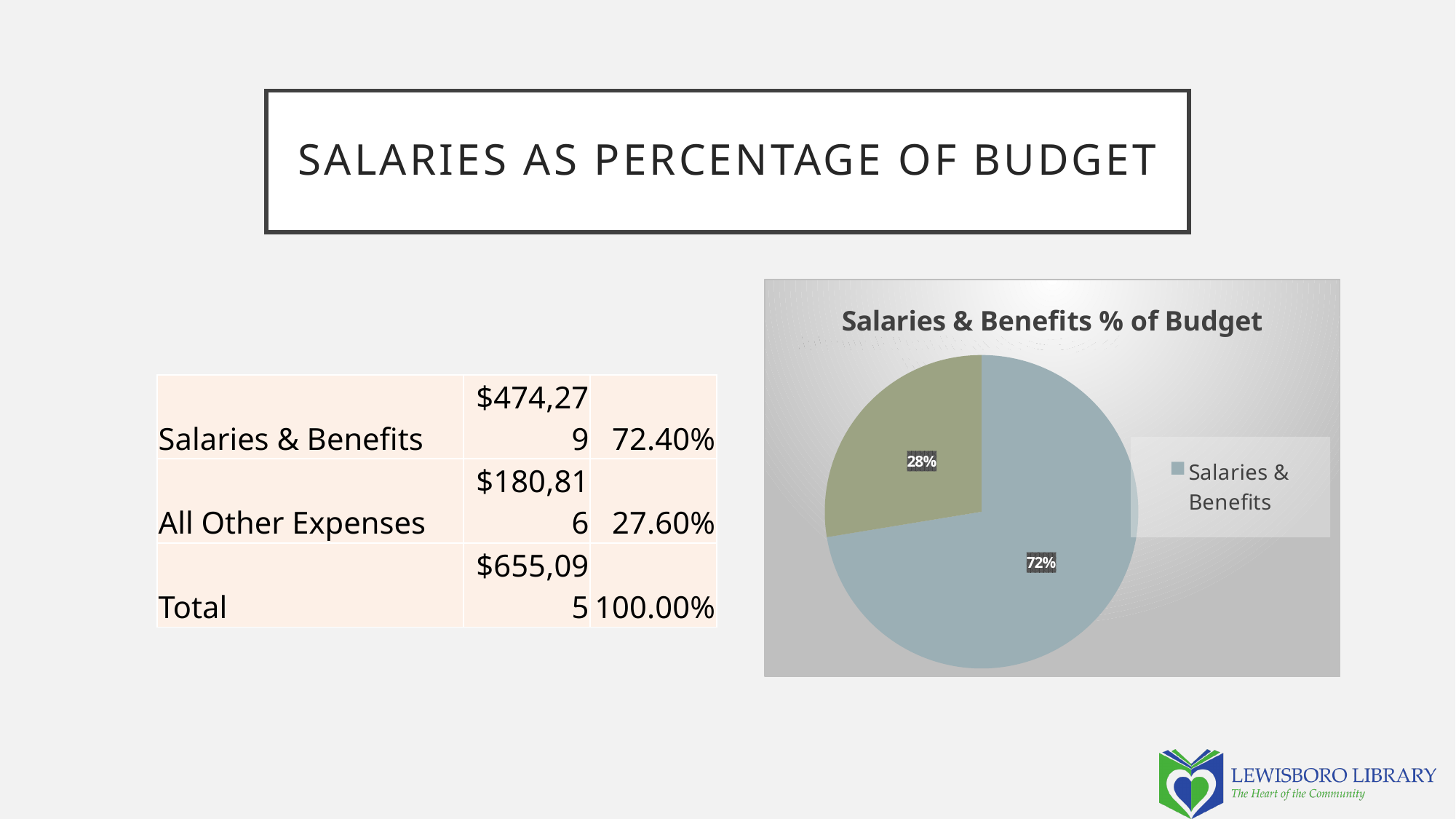
What do the two slice percentages in the pie chart add up to? 100% What kind of chart is shown on the slide? Pie chart What percentage is printed on the smaller slice of the pie chart? 28% What is the title of the chart? Salaries & Benefits % of Budget Which slice of the pie chart is the largest? Salaries & Benefits Which is larger in the pie chart: the Salaries & Benefits slice or the other slice? Salaries & Benefits What is the difference in percentage points between the two slices of the pie chart? 44 Which category is listed in the chart's legend? Salaries & Benefits What percentage of the budget does the Salaries & Benefits slice represent in the pie chart? 72% How many slices does the pie chart have? 2 Is the Salaries & Benefits slice greater or less than 50% of the pie? greater